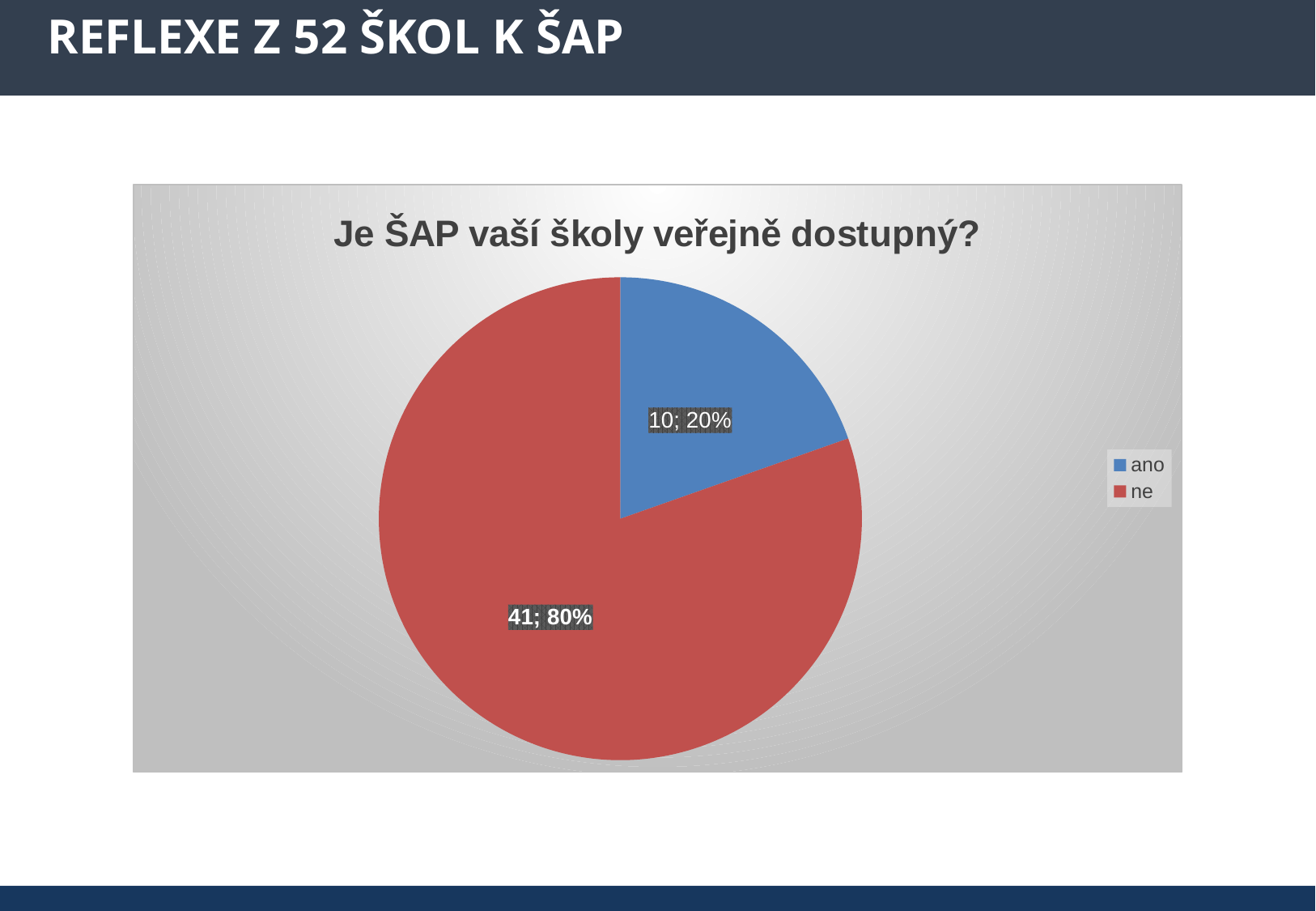
What share of the pie does the "ne" slice represent? 80% How many slices does the pie chart have? 2 Which slice is the largest? ne What is the count shown for the "ano" slice? 10 Which colour represents the "ano" slice? blue What is the count shown for the "ne" slice? 41 What is the title of the chart? Je ŠAP vaší školy veřejně dostupný? What is the difference between the counts for "ne" and "ano"? 31 What share of the pie does the "ano" slice represent? 20% What kind of chart is shown on the slide? pie chart How many entries does the legend list? 2 Which slice is the smallest? ano